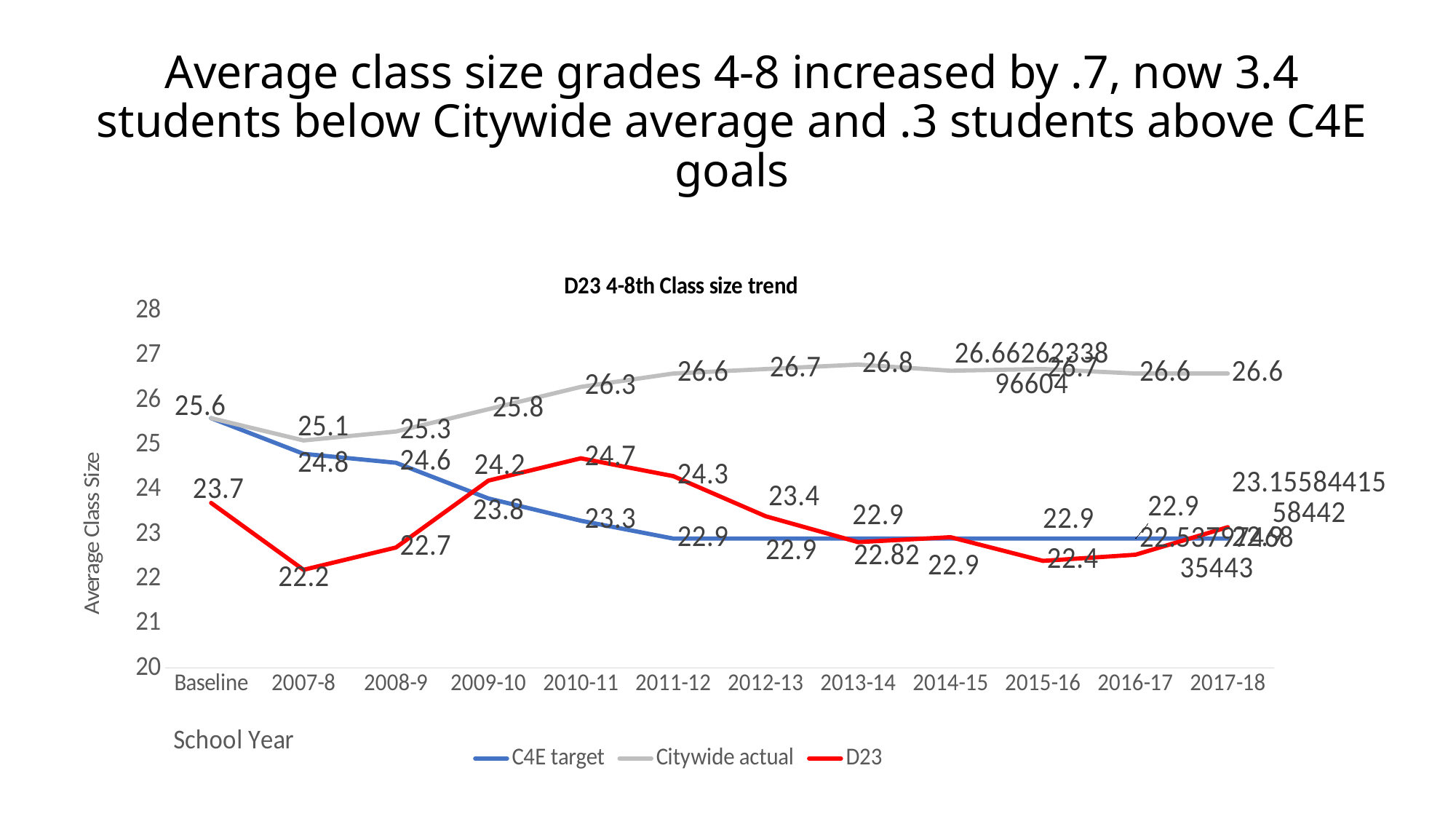
In 2009-10, which is larger: the D23 value or the C4E target value? D23 What is the D23 value for 2007-8? 22.2 What is the D23 value at Baseline? 23.7 What is the difference between the Citywide actual and D23 values in 2010-11? 1.6 How many series does the legend list? 3 How many school years (categories) are shown on the x axis? 12 What is the C4E target value for 2007-8? 24.8 What kind of chart is shown on the slide? line chart Does the Citywide actual line rise or fall from 2007-8 to 2013-14? rise In which school year is the D23 value lowest? 2007-8 What is the Citywide actual value for 2013-14? 26.8 In which school year is the D23 value highest? 2010-11